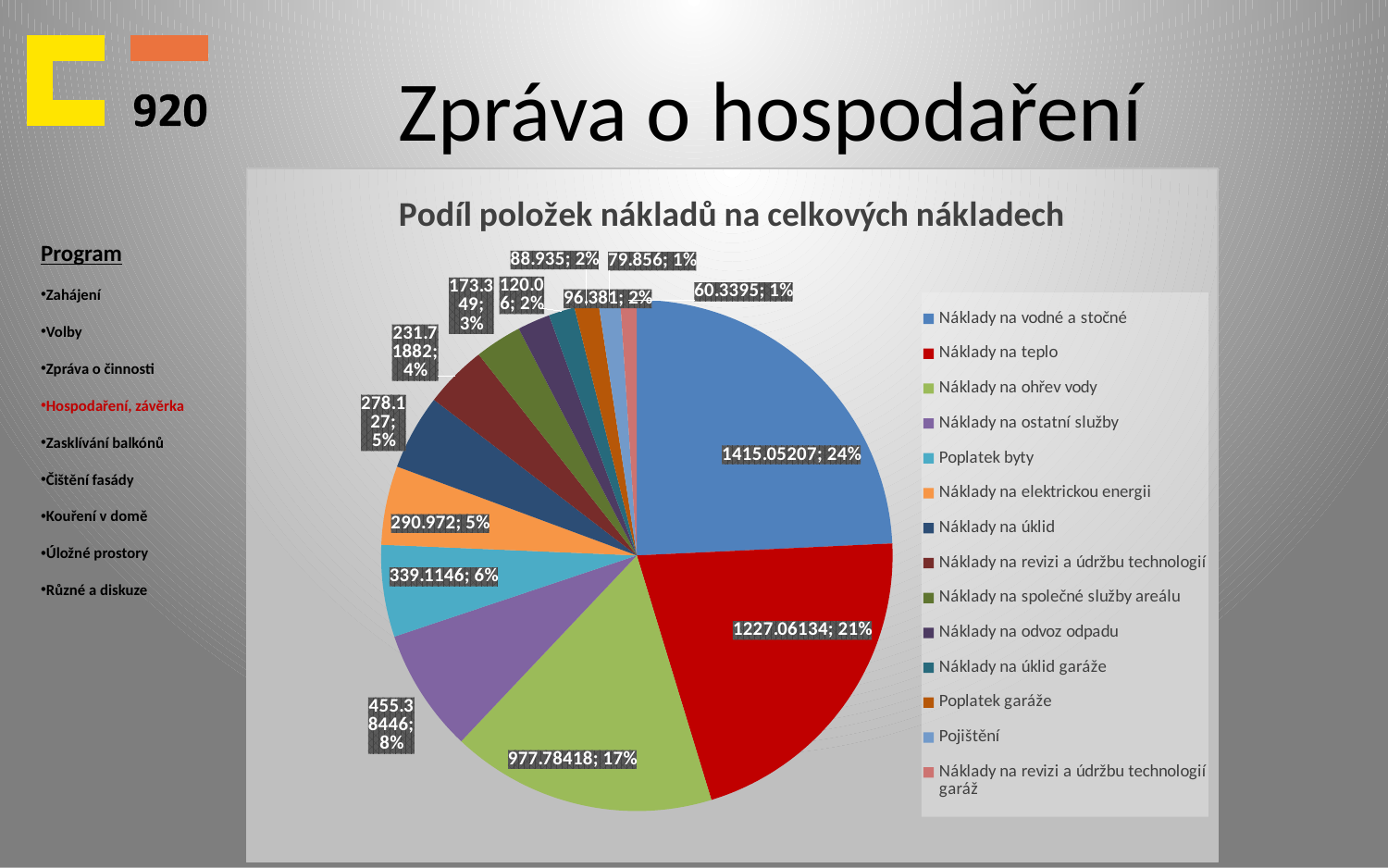
What is the difference between the values for Náklady na vodné a stočné and Náklady na teplo? 187.99073 What value is shown for Náklady na ohřev vody? 977.78418 What is the title of the chart? Podíl položek nákladů na celkových nákladech What value is shown for Poplatek byty? 339.1146 How many entries does the chart legend list? 14 What share of the pie does Náklady na teplo represent? 21% What share of the pie does Náklady na ostatní služby represent? 8% What value is shown for Náklady na vodné a stočné? 1415.05207 What kind of chart is shown on the slide? pie chart Which cost item has the largest slice of the pie? Náklady na vodné a stočné What share of the pie does Náklady na revizi a údržbu technologií represent? 4% Which is larger, Náklady na elektrickou energii or Náklady na ohřev vody? Náklady na ohřev vody